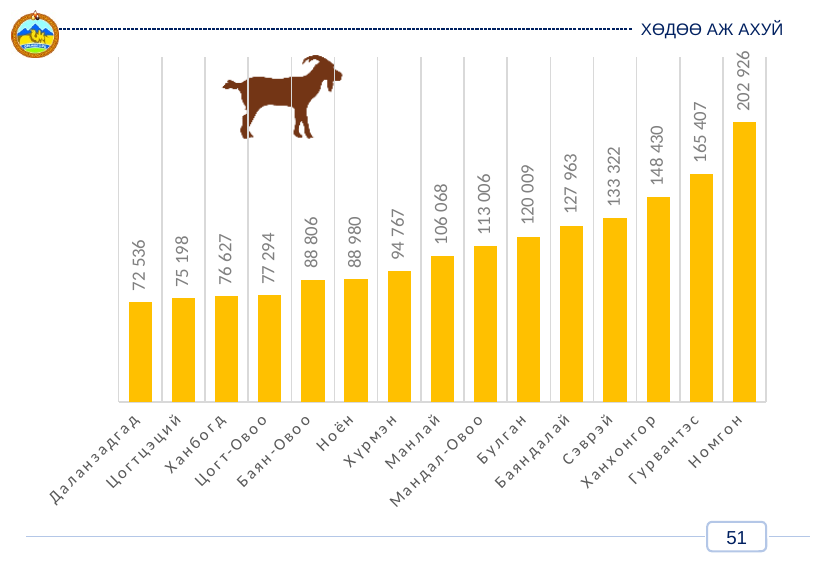
Which category has the lowest value? Даланзадгад What is the value for Ханхонгор? 148 430 How many categories are shown on the x axis? 15 What is the value for Мандал-Овоо? 113 006 What is the value for Даланзадгад? 72 536 What kind of chart is shown on the slide? Bar chart What is the value for Номгон? 202 926 What is the difference between the values for Булган and Хүрмэн? 25 242 Which category has the highest value? Номгон Which is larger, the value for Сэврэй or the value for Баяндалай? Сэврэй Do the values rise or fall from left to right along the x axis? Rise What is the difference between the values for Номгон and Гурвантэс? 37 519